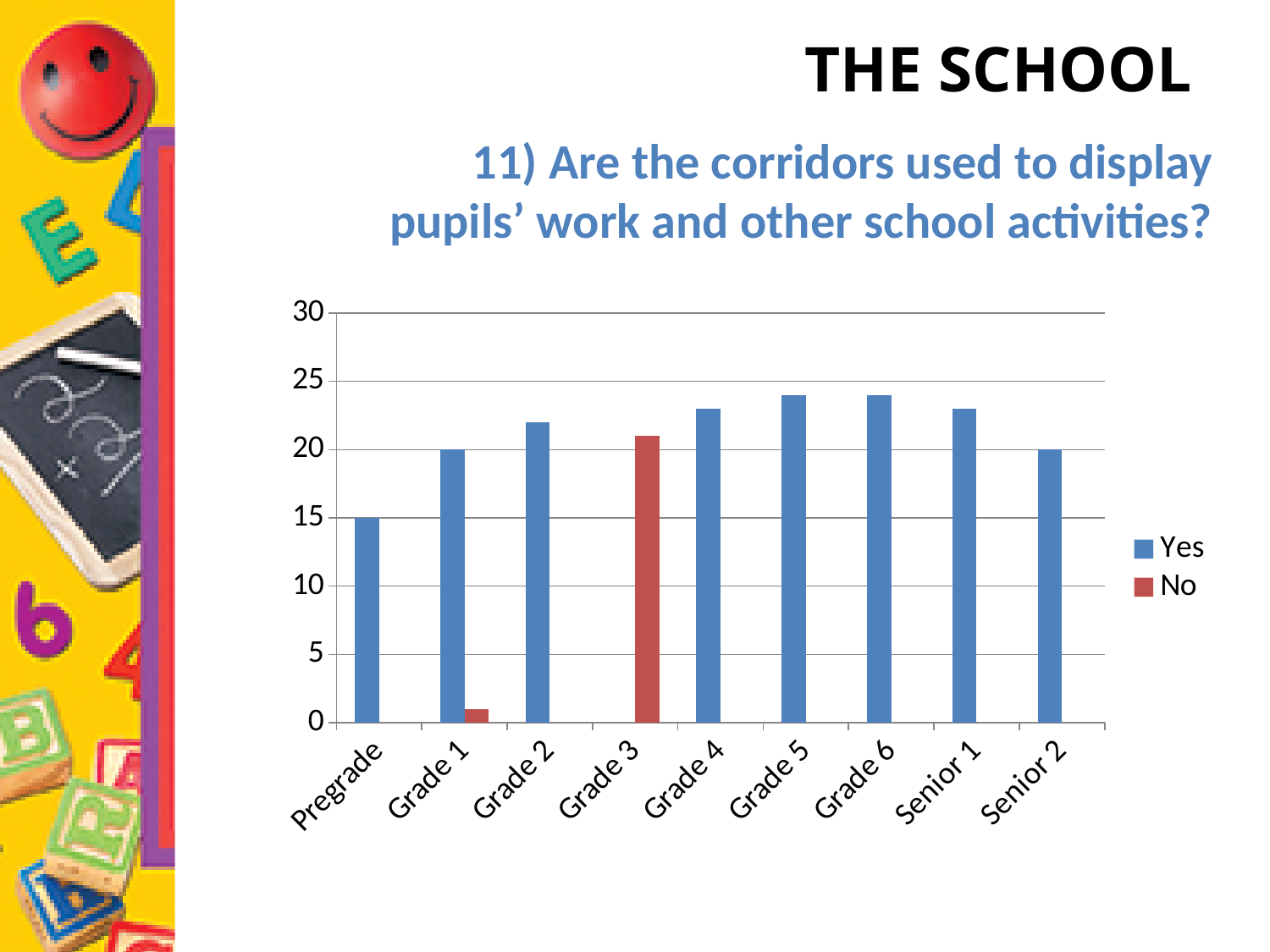
How many categories are shown on the x axis? 9 What is the Yes value for Senior 2? 20 Is the Yes value for Grade 5 greater or less than 25? less Which category has the lowest Yes value? Grade 3 Is the No value for Grade 3 greater or less than 20? greater Which is larger, the Yes value for Grade 2 or the Yes value for Pregrade? Grade 2 Which category has a No bar that is taller than its Yes bar? Grade 3 What is the Yes value for Pregrade? 15 What is the Yes value for Grade 1? 20 Is the No value for Grade 1 greater or less than 5? less What kind of chart is shown on the slide? bar chart How many series does the legend list? 2